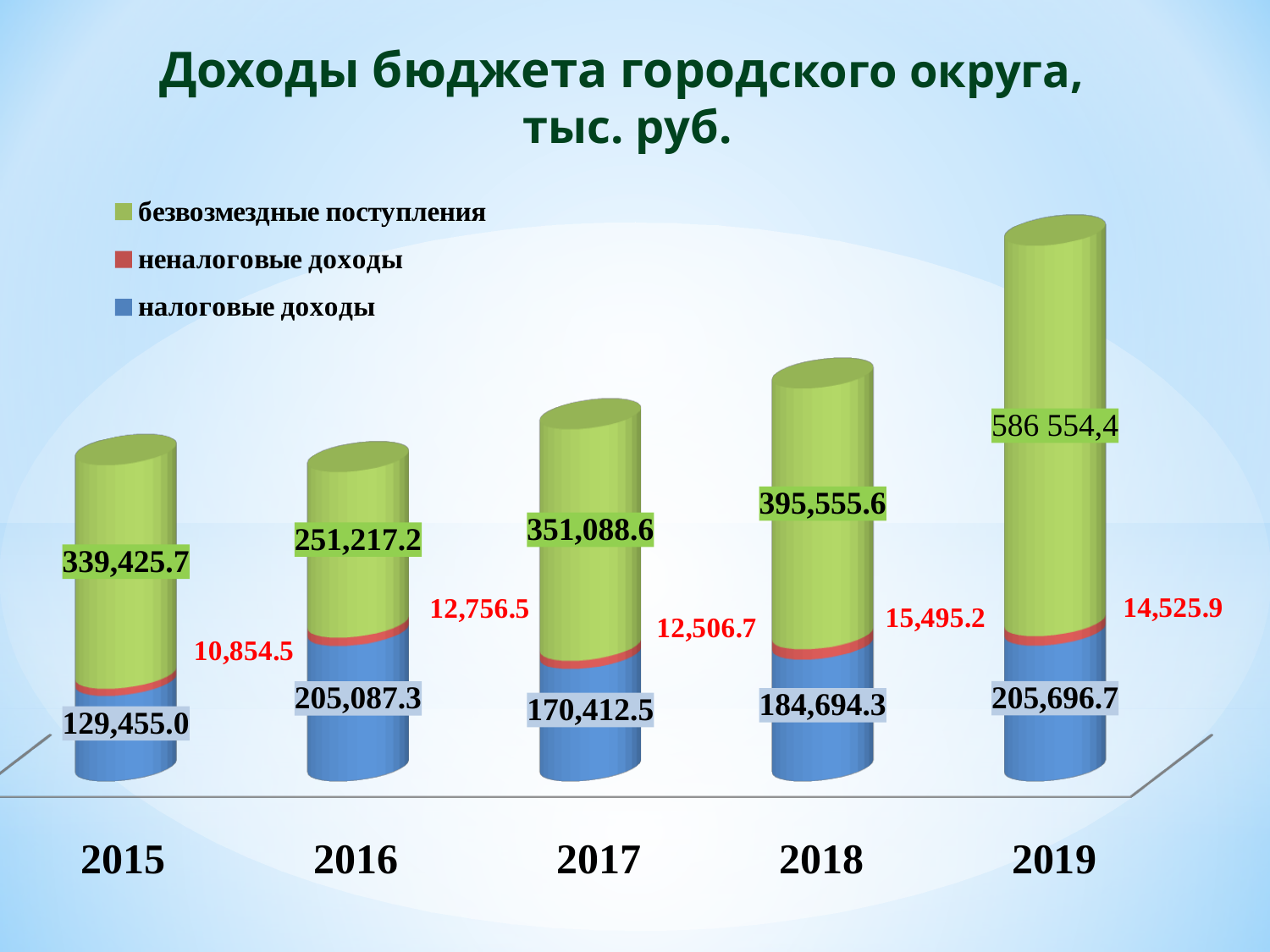
What is the value of неналоговые доходы for 2017? 12,506.7 What is the value of налоговые доходы for 2015? 129,455.0 What is the value of безвозмездные поступления for 2019? 586 554,4 In which year are безвозмездные поступления the highest? 2019 Which year has larger неналоговые доходы, 2016 or 2017? 2016 How many years are shown on the x axis? 5 In which year are неналоговые доходы the highest? 2018 How many series does the legend list? 3 What is the total of the stacked bar for 2018? 595,745.1 What is the difference in налоговые доходы between 2016 and 2015? 75,632.3 In which year are налоговые доходы the lowest? 2015 What is the value of безвозмездные поступления for 2018? 395,555.6